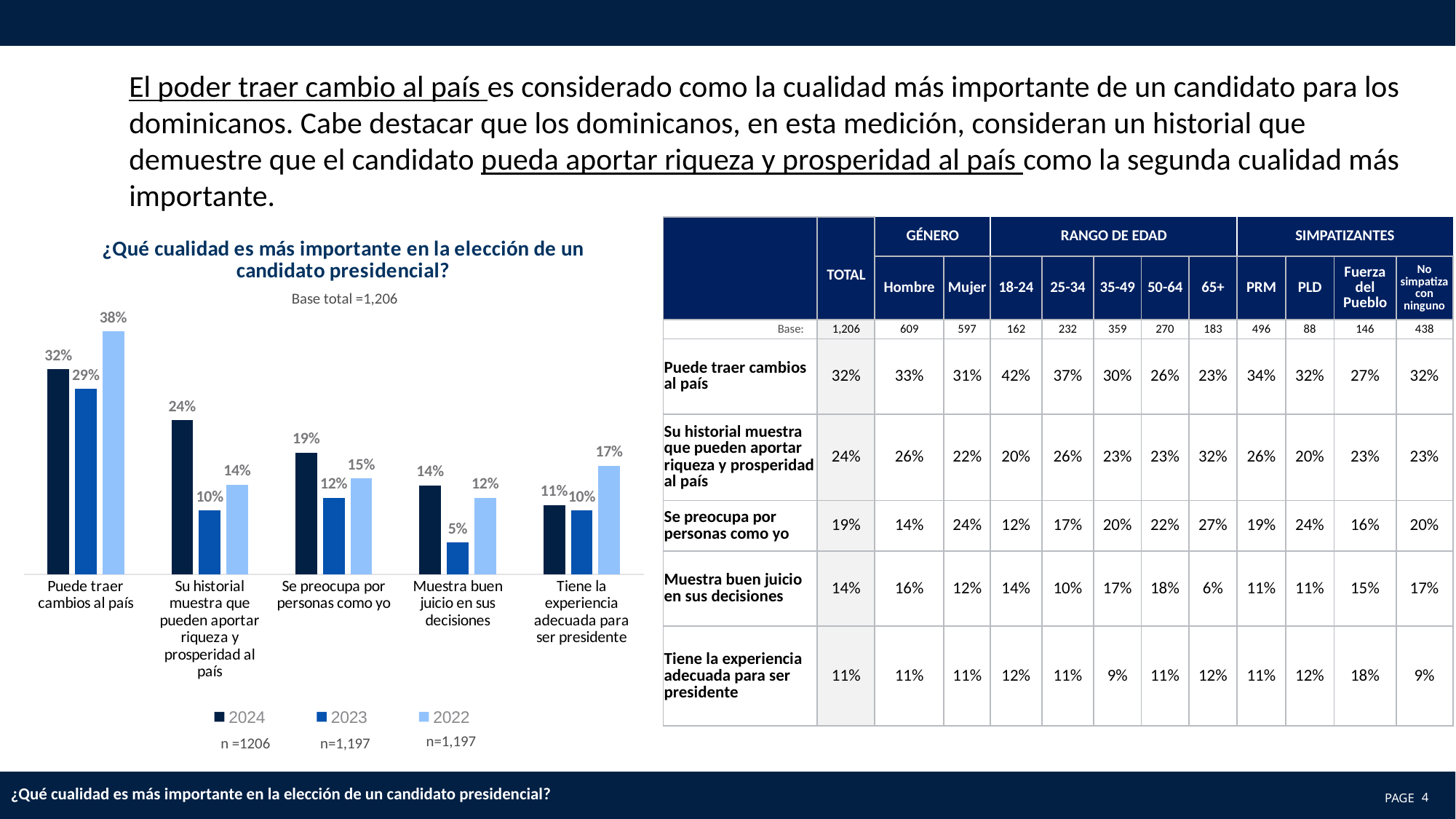
What is the 2022 value for 'Tiene la experiencia adecuada para ser presidente'? 17% What type of chart is shown on the slide? Bar chart What is the title of the chart? ¿Qué cualidad es más importante en la elección de un candidato presidencial? What is the 2023 value for 'Muestra buen juicio en sus decisiones'? 5% Which category has the lowest 2023 value? Muestra buen juicio en sus decisiones Which is larger for 'Se preocupa por personas como yo': the 2024 value or the 2022 value? 2024 Which category has the highest 2022 value? Puede traer cambios al país How many series does the chart legend list? 3 How many categories are shown on the x axis of the chart? 5 What is the difference between the 2024 and 2023 values for 'Su historial muestra que pueden aportar riqueza y prosperidad al país'? 14% What is the 2024 value for 'Puede traer cambios al país'? 32% What is the base total stated under the chart title? 1,206